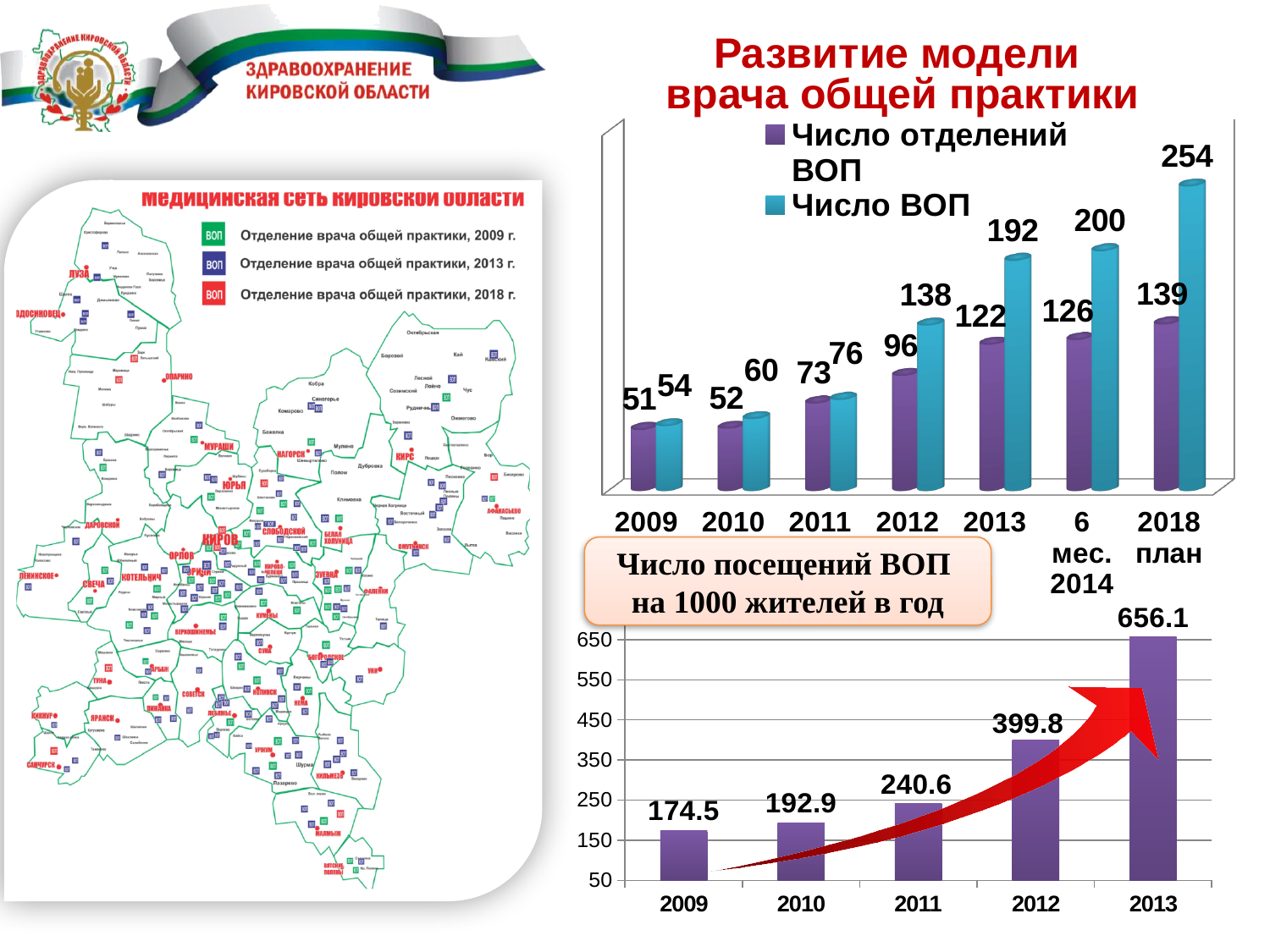
In the bottom chart 'Число посещений ВОП на 1000 жителей в год', do the values rise or fall from 2009 to 2013? rise In the top chart 'Развитие модели врача общей практики', which category has the lowest value of 'Число отделений ВОП'? 2009 In the bottom chart 'Число посещений ВОП на 1000 жителей в год', what is the value for 2012? 399.8 In the top chart 'Развитие модели врача общей практики', what is the value of 'Число ВОП' for 2013? 192 In the bottom chart 'Число посещений ВОП на 1000 жителей в год', what is the difference between the values for 2013 and 2012? 256.3 In the bottom chart 'Число посещений ВОП на 1000 жителей в год', which year has the highest value? 2013 In the top chart 'Развитие модели врача общей практики', how many series does the legend list? 2 In the top chart 'Развитие модели врача общей практики', what is the planned value of 'Число ВОП' for 2018 (2018 план)? 254 What kind of chart is the bottom chart 'Число посещений ВОП на 1000 жителей в год'? bar chart In the top chart 'Развитие модели врача общей практики', how many categories are shown on the x axis? 7 In the top chart 'Развитие модели врача общей практики', what is the value of 'Число отделений ВОП' for 2012? 96 In the top chart 'Развитие модели врача общей практики', what is the difference between 'Число ВОП' and 'Число отделений ВОП' for 2013? 70